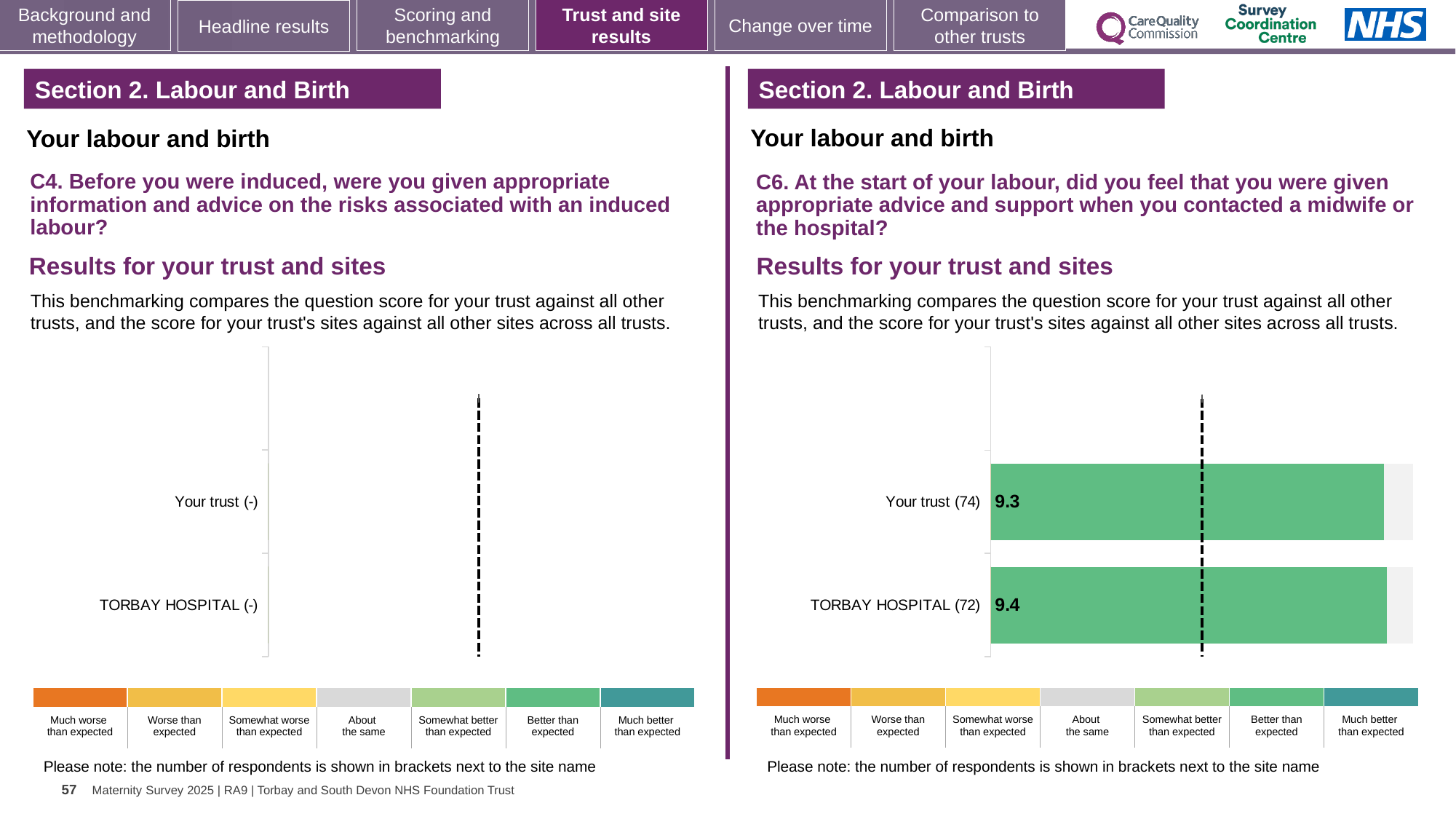
In the right-hand chart (C6), what is the score for Your trust (74)? 9.3 In the right-hand chart (C6), what is the score for TORBAY HOSPITAL (72)? 9.4 How many category labels are listed on the y axis of the left-hand chart (C4)? 2 In the right-hand chart (C6), which has the higher score, Your trust or TORBAY HOSPITAL? TORBAY HOSPITAL How many benchmark categories are shown in the colour legend below the left-hand chart (C4)? 7 In the right-hand chart (C6), how many respondents are shown in brackets for Your trust? 74 In the right-hand chart (C6), how many respondents are shown in brackets for TORBAY HOSPITAL? 72 In the right-hand chart (C6), which category has the lowest score? Your trust (74) What type of chart is used in the right-hand chart (C6)? Bar chart In the right-hand chart (C6), what is the difference between the TORBAY HOSPITAL score and the Your trust score? 0.1 How many bars are plotted in the right-hand chart (C6)? 2 In the right-hand chart (C6), which benchmark category does the green colour of the bars correspond to in the legend? Better than expected